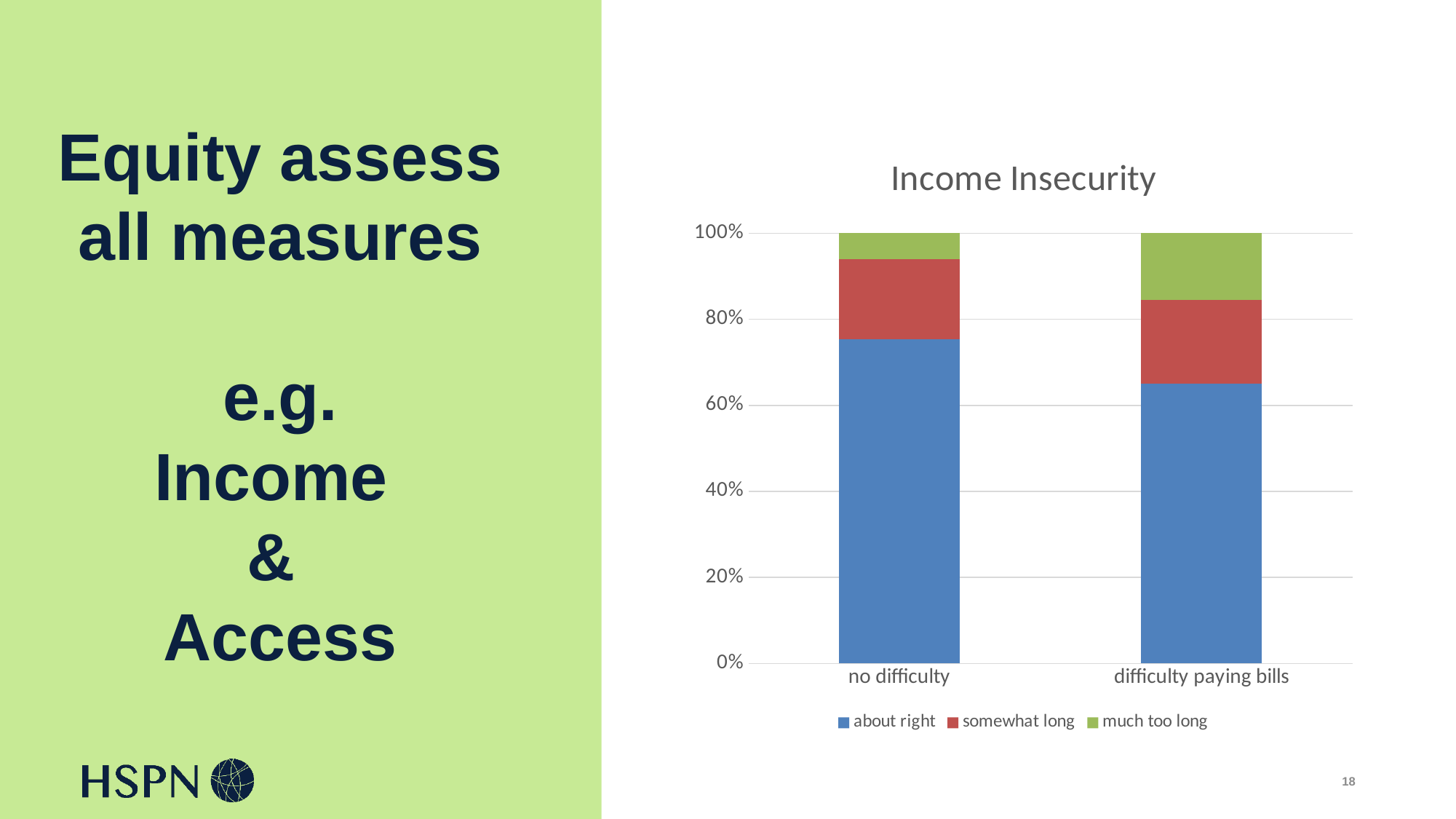
Which category has the larger 'about right' share: 'no difficulty' or 'difficulty paying bills'? no difficulty Is the 'about right' share for 'difficulty paying bills' greater or less than 80%? less What is the total height of the stacked bar for 'no difficulty'? 100% Is the 'about right' share for 'no difficulty' greater or less than 60%? greater What is the title of the chart? Income Insecurity Does the 'about right' share rise or fall from 'no difficulty' to 'difficulty paying bills'? fall What kind of chart is shown on the slide? stacked bar chart Which category has the larger 'much too long' share: 'no difficulty' or 'difficulty paying bills'? difficulty paying bills How many series does the chart's legend list? 3 Which category has the highest 'much too long' share? difficulty paying bills How many categories are shown on the x axis of the chart? 2 Which series is shown in green in the chart? much too long